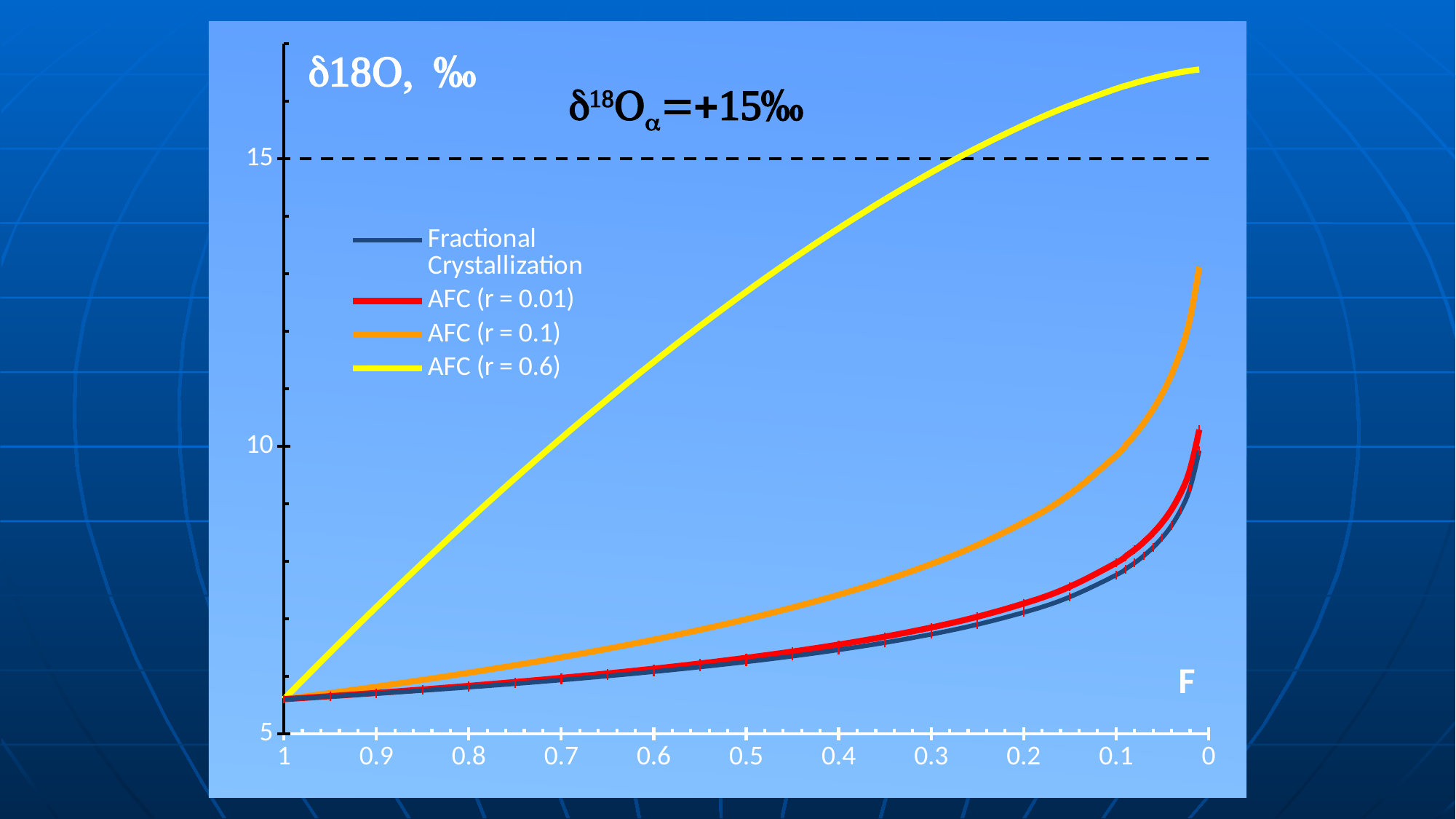
Which series reaches the highest δ18O value at F = 0? AFC (r = 0.6) How many series does the legend list? 4 Is the value of AFC (r = 0.6) at F = 0.5 greater or less than 10? greater Is the value of AFC (r = 0.1) at F = 0 greater or less than 15? less At F = 0.2, which is larger: AFC (r = 0.1) or Fractional Crystallization? AFC (r = 0.1) Which series has the lowest δ18O value at F = 0.5? Fractional Crystallization Which series is plotted in yellow? AFC (r = 0.6) What kind of chart is shown on the slide? line chart As F decreases from 1 to 0, do the δ18O values of the series rise or fall? rise Is the value of AFC (r = 0.01) at F = 0.5 greater or less than 10? less What value does the horizontal dashed line mark on the y axis? 15